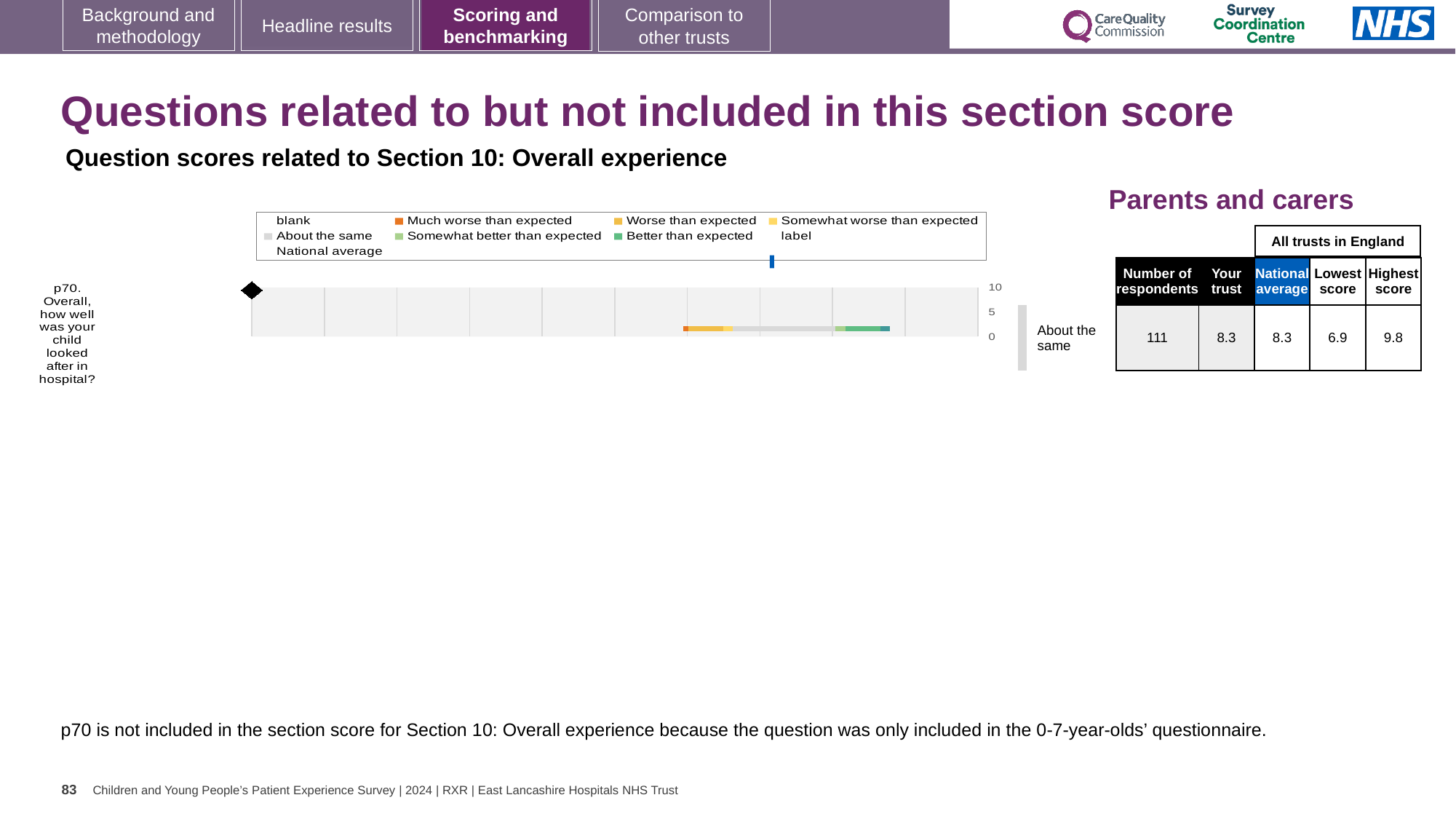
What is the difference between the highest score and the lowest score for p70 in the Parents and carers table? 2.9 What category label is shown to the right of the bar for p70? About the same What kind of chart is shown for question p70? bar chart In the Parents and carers table, what is the national average score for p70? 8.3 In the Parents and carers table, what is the number of respondents for p70? 111 In the Parents and carers table, what is the 'Your trust' score for p70? 8.3 In the Parents and carers table, what is the lowest score among all trusts in England for p70? 6.9 In the Parents and carers table, what is the highest score among all trusts in England for p70? 9.8 How many survey questions are plotted in the chart? 1 Which survey question is plotted in the chart? p70. Overall, how well was your child looked after in hospital? What is the highest value shown on the chart's axis? 10 Is the 'Your trust' score for p70 higher than, lower than, or equal to the national average? equal